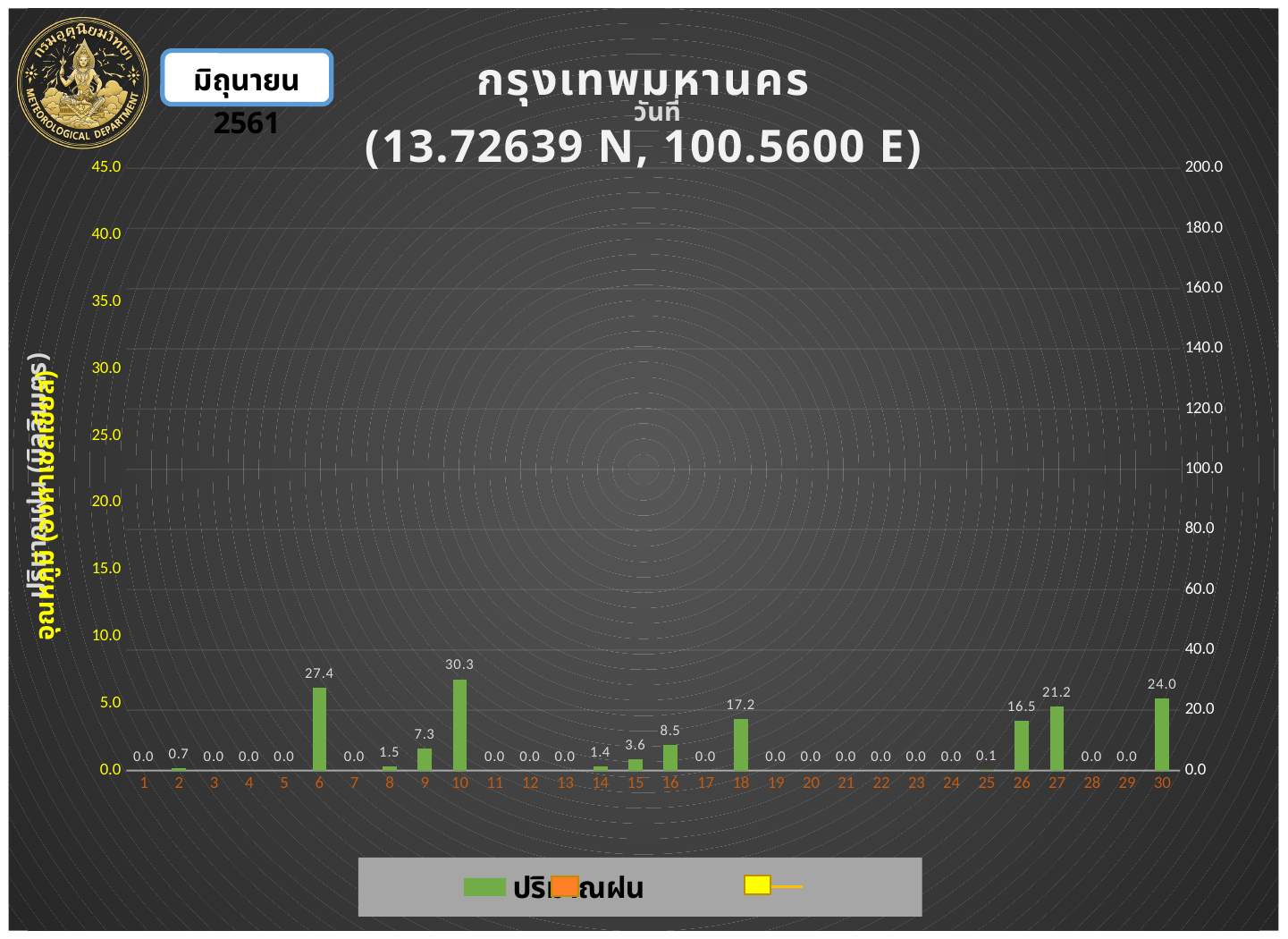
What coordinates are given in the chart title? 13.72639 N, 100.5600 E What is the difference between the values for day 10 and day 6? 2.9 What kind of chart is shown on the slide? bar chart What is the value for day 10? 30.3 How many days are shown on the x axis? 30 What is the value for day 6? 27.4 What is the value for day 18? 17.2 What is the value for day 27? 21.2 What is the value for day 25? 0.1 Which is larger, the value for day 26 or the value for day 27? day 27 Which day has the highest value? 10 What is the difference between the values for day 30 and day 27? 2.8